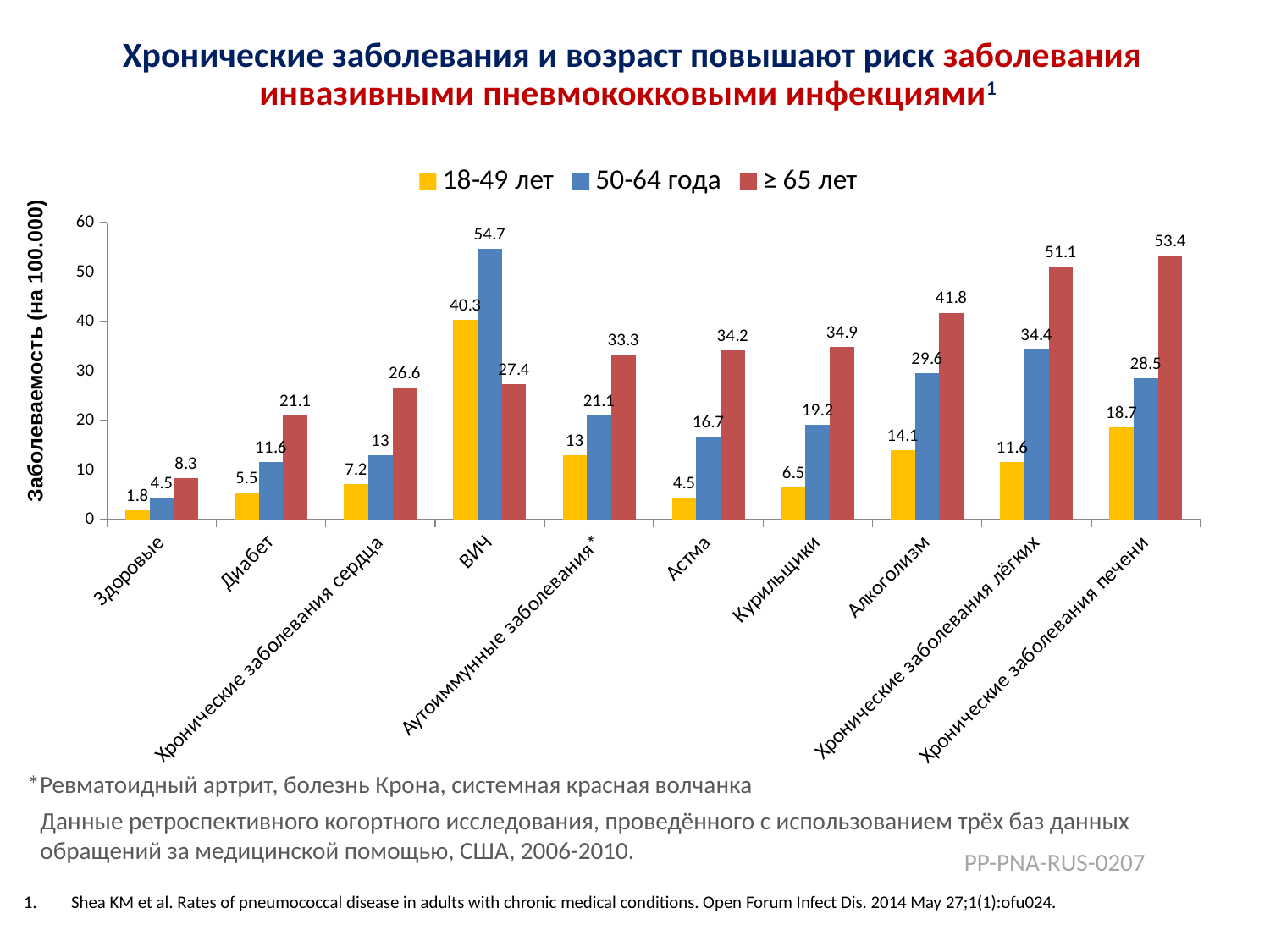
What is the value for the ≥ 65 лет series in the ВИЧ category? 27.4 What type of chart is shown on the slide? Bar chart What is the value for the 18-49 лет series in the Алкоголизм category? 14.1 What is the value for the 50-64 года series in the Хронические заболевания лёгких category? 34.4 What is the label of the vertical axis? Заболеваемость (на 100.000) Which is larger: the 50-64 года value for Курильщики or the 50-64 года value for Астма? Курильщики Which category has the highest value for the 18-49 лет series? ВИЧ What is the difference between the ≥ 65 лет and 18-49 лет values in the Хронические заболевания печени category? 34.7 Which category has the lowest value for the ≥ 65 лет series? Здоровые How many series does the legend list? 3 How many categories are shown on the x axis? 10 Which series is shown in yellow? 18-49 лет